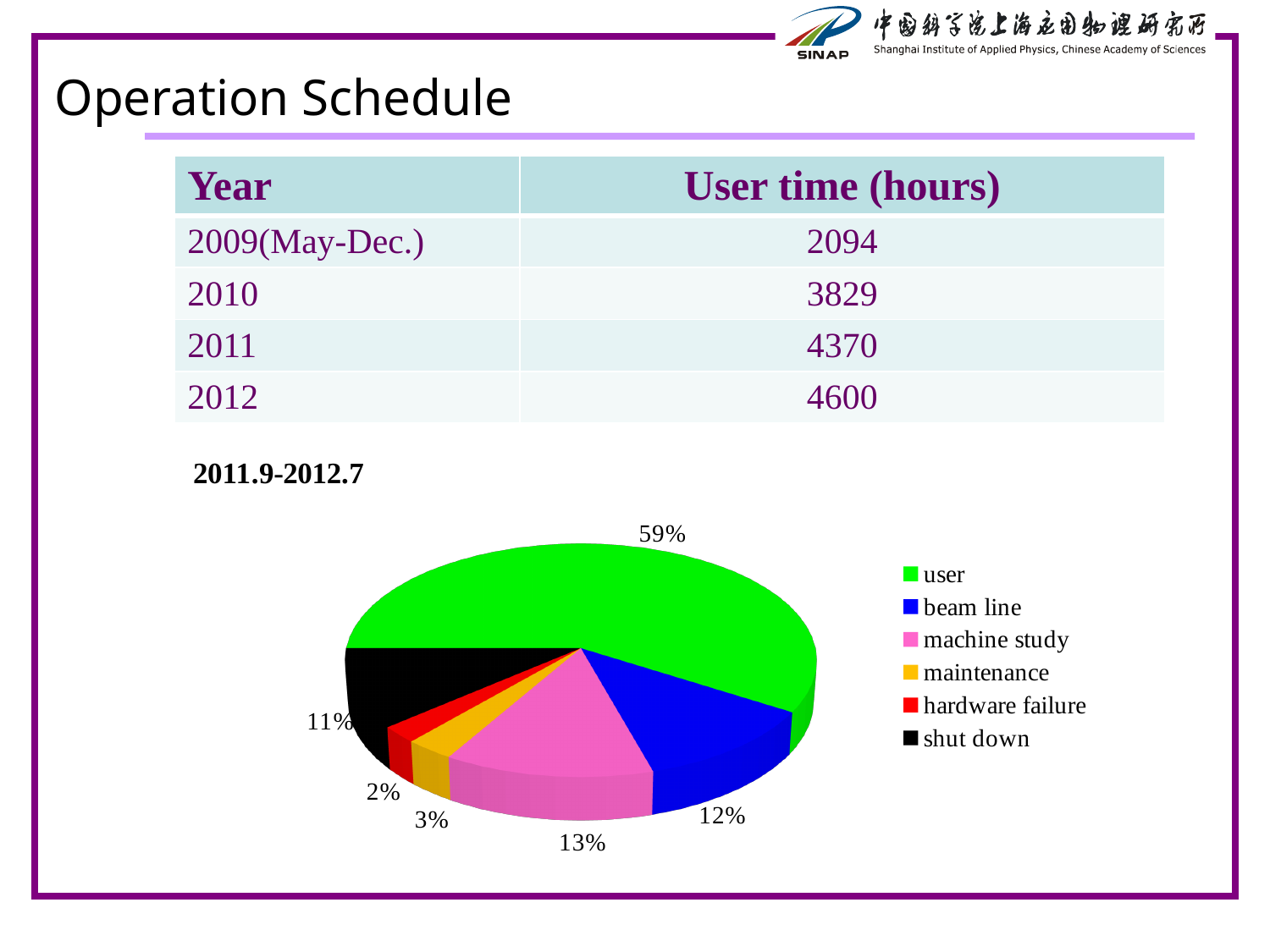
Which category has the smallest slice in the pie chart? hardware failure What share of the pie chart does the maintenance slice represent? 3% What share of the pie chart does the beam line slice represent? 12% Which category has the largest slice in the pie chart? user What is the difference in percentage points between the user slice and the shut down slice? 48% What kind of chart is shown on the slide? pie chart What share of the pie chart does the shut down slice represent? 11% What period is given as the title above the pie chart? 2011.9-2012.7 How many categories does the pie chart legend list? 6